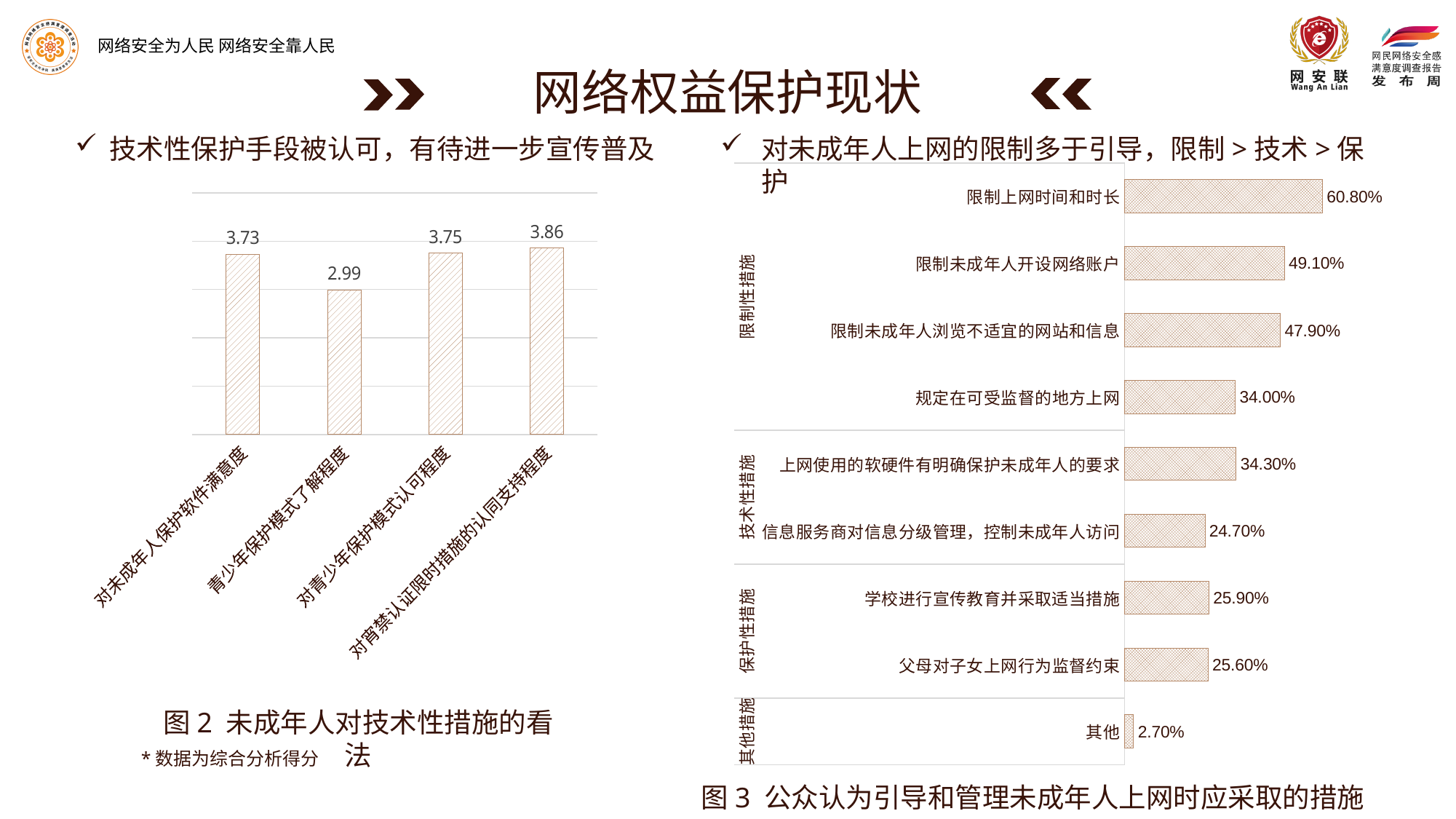
In the right chart (图3), how many categories are plotted? 9 In the right chart (图3), which category has the lowest value? 其他 In the right chart (图3), what is the difference between 限制上网时间和时长 and 规定在可受监督的地方上网? 26.80% In the right chart (图3), which is larger: 限制未成年人开设网络账户 or 限制未成年人浏览不适宜的网站和信息? 限制未成年人开设网络账户 In the left chart (图2), which category has the highest value? 对宵禁认证限时措施的认同支持程度 In the right chart (图3), what is the value for 信息服务商对信息分级管理，控制未成年人访问? 24.70% In the left chart (图2 未成年人对技术性措施的看法), what is the value for 青少年保护模式了解程度? 2.99 In the right chart (图3 公众认为引导和管理未成年人上网时应采取的措施), what is the value for 限制上网时间和时长? 60.80% In the left chart (图2), how many categories are plotted? 4 In the left chart (图2), which category has the lowest value? 青少年保护模式了解程度 In the left chart (图2), what is the difference between 对宵禁认证限时措施的认同支持程度 and 青少年保护模式了解程度? 0.87 What kind of chart is the left chart (图2)? Bar chart